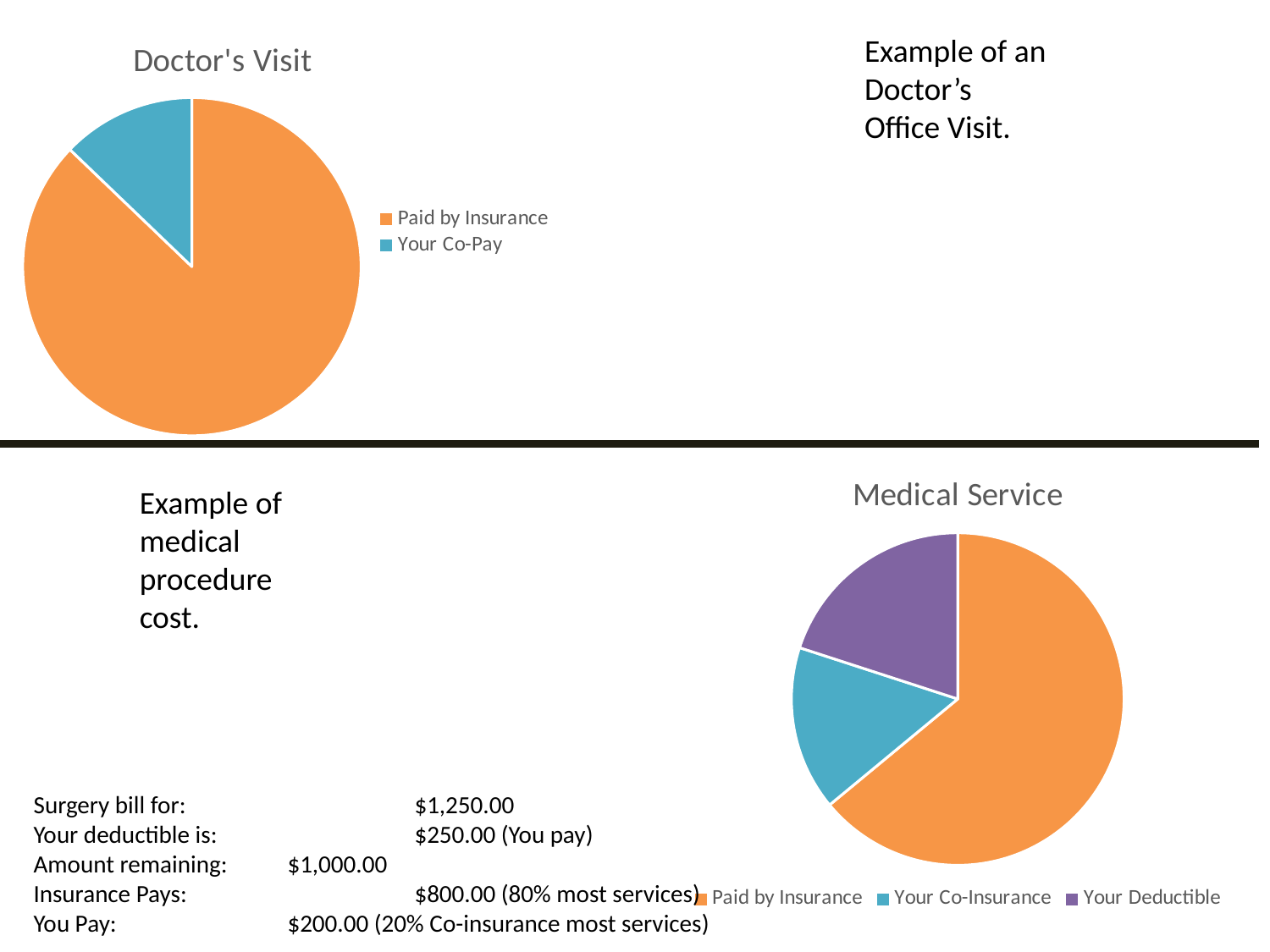
What kind of chart is the Doctor's Visit chart? pie chart How many slices does the Medical Service pie chart have? 3 In the Doctor's Visit chart, which slice is the smallest? Your Co-Pay In the Medical Service chart, which legend entry is shown in purple? Your Deductible In the Medical Service chart, which slice is the largest? Paid by Insurance What kind of chart is the Medical Service chart? pie chart In the Medical Service chart, which slice is larger: Your Co-Insurance or Paid by Insurance? Paid by Insurance How many entries does the legend of the Medical Service chart list? 3 In the Doctor's Visit chart, which slice is the largest? Paid by Insurance How many entries does the legend of the Doctor's Visit chart list? 2 How many slices does the Doctor's Visit pie chart have? 2 What is the title of the pie chart in the lower half of the slide? Medical Service